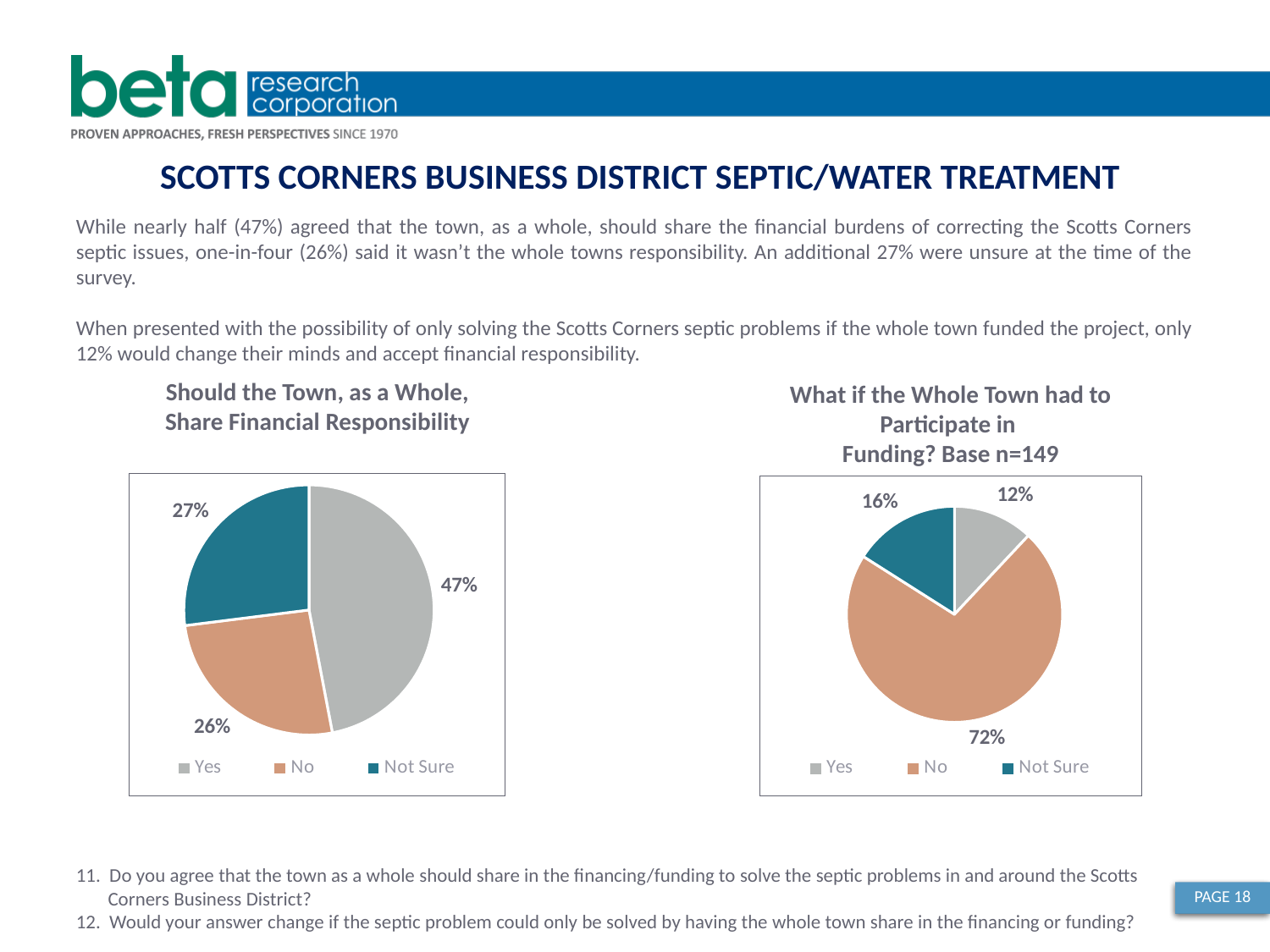
In the 'What if the Whole Town had to Participate in Funding?' chart, what percentage answered Yes? 12% In the 'Should the Town, as a Whole, Share Financial Responsibility' chart, what percentage answered No? 26% In the 'What if the Whole Town had to Participate in Funding?' chart, what is the difference between the No and Not Sure percentages? 56% In the 'What if the Whole Town had to Participate in Funding?' chart, which response has the smallest share? Yes How many categories does the legend of the 'What if the Whole Town had to Participate in Funding?' chart list? 3 In the 'Should the Town, as a Whole, Share Financial Responsibility' chart, what percentage answered Yes? 47% In the 'Should the Town, as a Whole, Share Financial Responsibility' chart, which response has the largest share? Yes In the 'What if the Whole Town had to Participate in Funding?' chart, which response has the largest share? No In the 'Should the Town, as a Whole, Share Financial Responsibility' chart, what percentage answered Not Sure? 27% In the 'Should the Town, as a Whole, Share Financial Responsibility' chart, what is the difference between the Yes and No percentages? 21% In the 'What if the Whole Town had to Participate in Funding?' chart, what percentage answered No? 72% What type of chart is the 'Should the Town, as a Whole, Share Financial Responsibility' chart? Pie chart